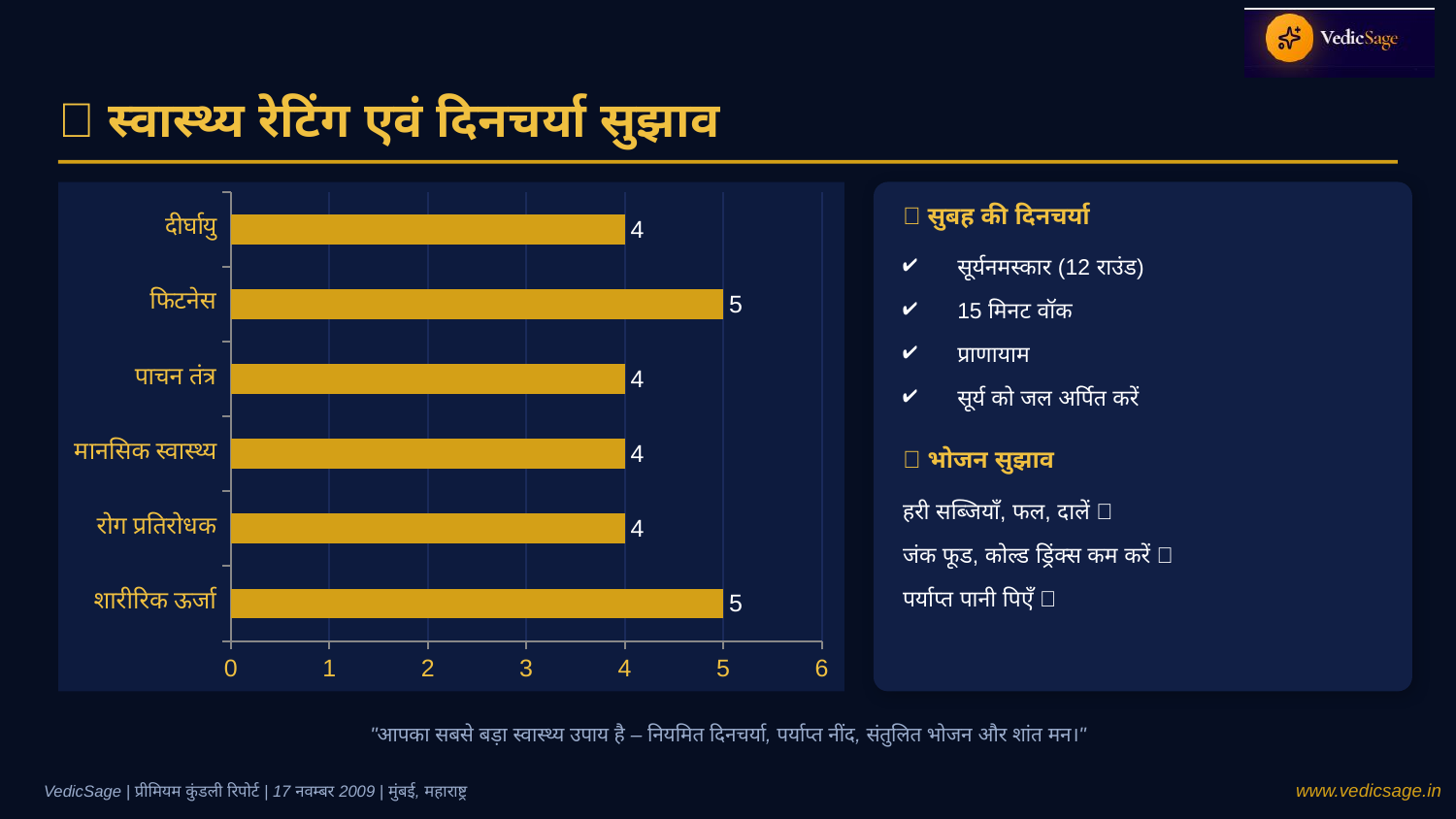
What is the value for शारीरिक ऊर्जा? 5 How many categories are shown in the chart? 6 What is the value for रोग प्रतिरोधक? 4 Is the value for पाचन तंत्र greater or less than 3? greater What colour are the bars in the chart? gold Which categories have the highest value in the chart? फिटनेस and शारीरिक ऊर्जा What is the value for मानसिक स्वास्थ्य? 4 What is the difference between the value for शारीरिक ऊर्जा and the value for दीर्घायु? 1 What is the value for फिटनेस? 5 Which is larger, the value for फिटनेस or the value for पाचन तंत्र? फिटनेस What is the value for दीर्घायु? 4 What kind of chart is shown on the slide? bar chart